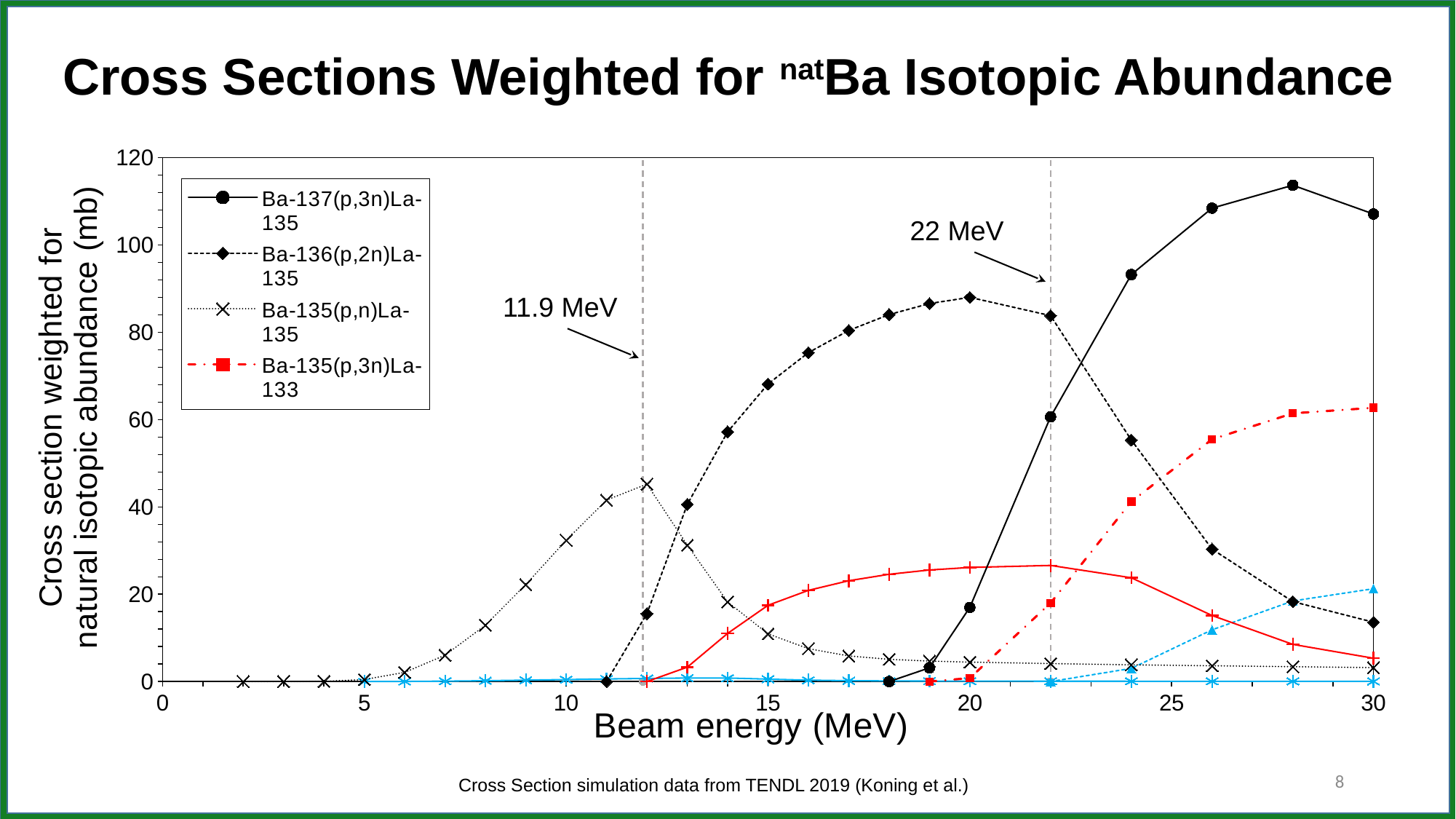
What kind of chart is shown on the slide? line chart At 15 MeV, which is larger: Ba-136(p,2n)La-135 or Ba-135(p,n)La-135? Ba-136(p,2n)La-135 Does the Ba-135(p,3n)La-133 series rise or fall between 20 MeV and 30 MeV? rise At 30 MeV, which is larger: Ba-137(p,3n)La-135 or Ba-136(p,2n)La-135? Ba-137(p,3n)La-135 Which series reaches the highest cross section on the chart? Ba-137(p,3n)La-135 How many series does the legend list? 4 Is the value for Ba-135(p,n)La-135 at 12 MeV greater or less than 40? greater What two beam energies are marked by the dashed vertical lines and annotations? 11.9 MeV and 22 MeV Is the value for Ba-137(p,3n)La-135 at 28 MeV greater or less than 100? greater Is the value for Ba-136(p,2n)La-135 at 20 MeV greater or less than 80? greater What is the label of the x axis? Beam energy (MeV)